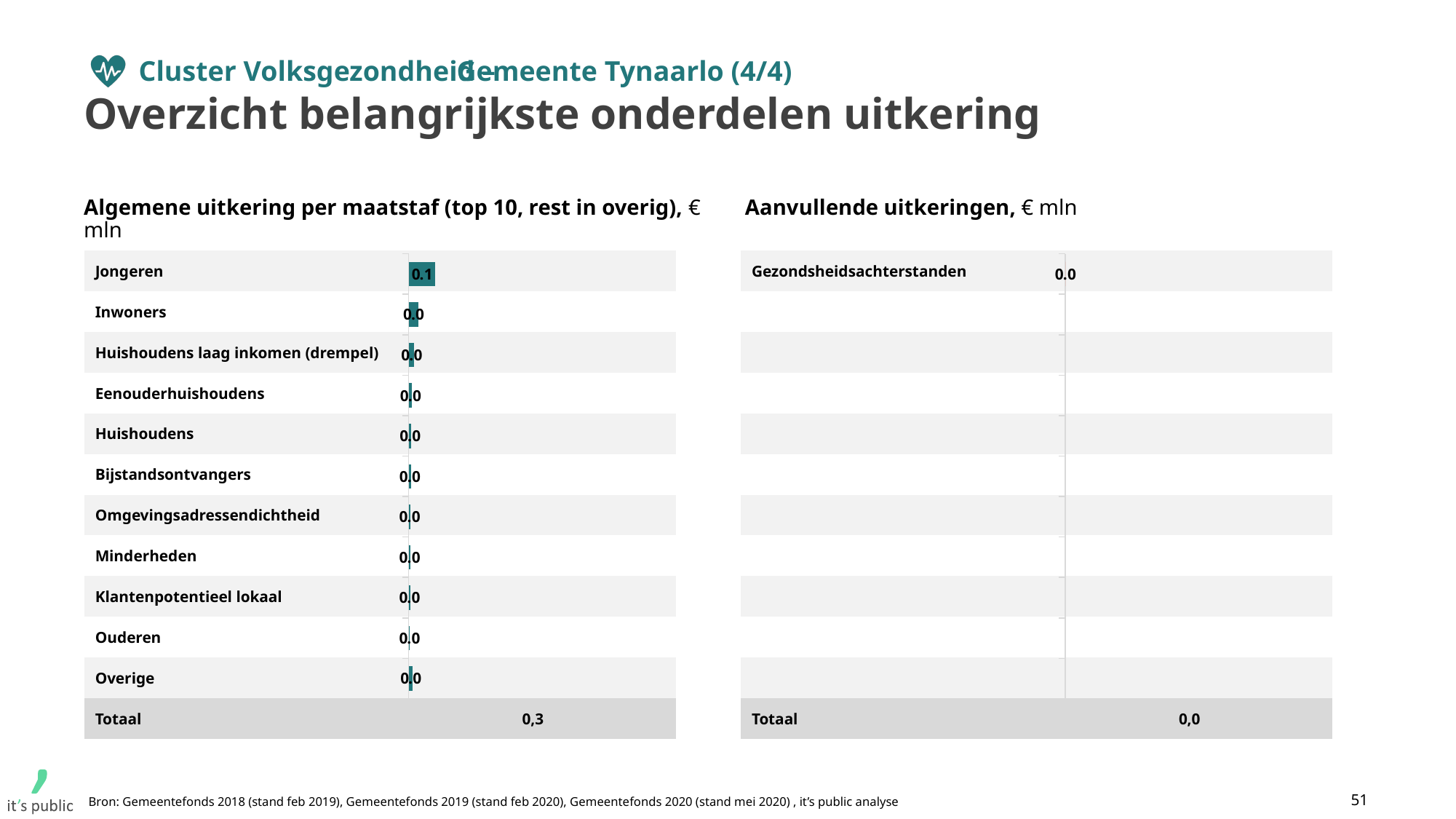
In the chart 'Algemene uitkering per maatstaf (top 10, rest in overig)', which category has the highest value? Jongeren What is the Totaal value shown under the chart 'Aanvullende uitkeringen'? 0,0 In the chart 'Algemene uitkering per maatstaf (top 10, rest in overig)', what is the value for Inwoners? 0.0 In what unit are the values of the chart 'Aanvullende uitkeringen' expressed, according to its title? € mln In the chart 'Algemene uitkering per maatstaf (top 10, rest in overig)', which is larger, the value for Jongeren or the value for Ouderen? Jongeren In the chart 'Aanvullende uitkeringen', what is the value for Gezondsheidsachterstanden? 0.0 In the chart 'Algemene uitkering per maatstaf (top 10, rest in overig)', what is the value for Jongeren? 0.1 What is the title of the chart on the left side of the slide? Algemene uitkering per maatstaf (top 10, rest in overig), € mln How many categories (excluding the Totaal row) are shown in the chart 'Algemene uitkering per maatstaf (top 10, rest in overig)'? 11 How many categories (excluding the Totaal row) are shown in the chart 'Aanvullende uitkeringen'? 1 What is the Totaal value shown under the chart 'Algemene uitkering per maatstaf (top 10, rest in overig)'? 0,3 What kind of chart is 'Algemene uitkering per maatstaf (top 10, rest in overig)'? bar chart